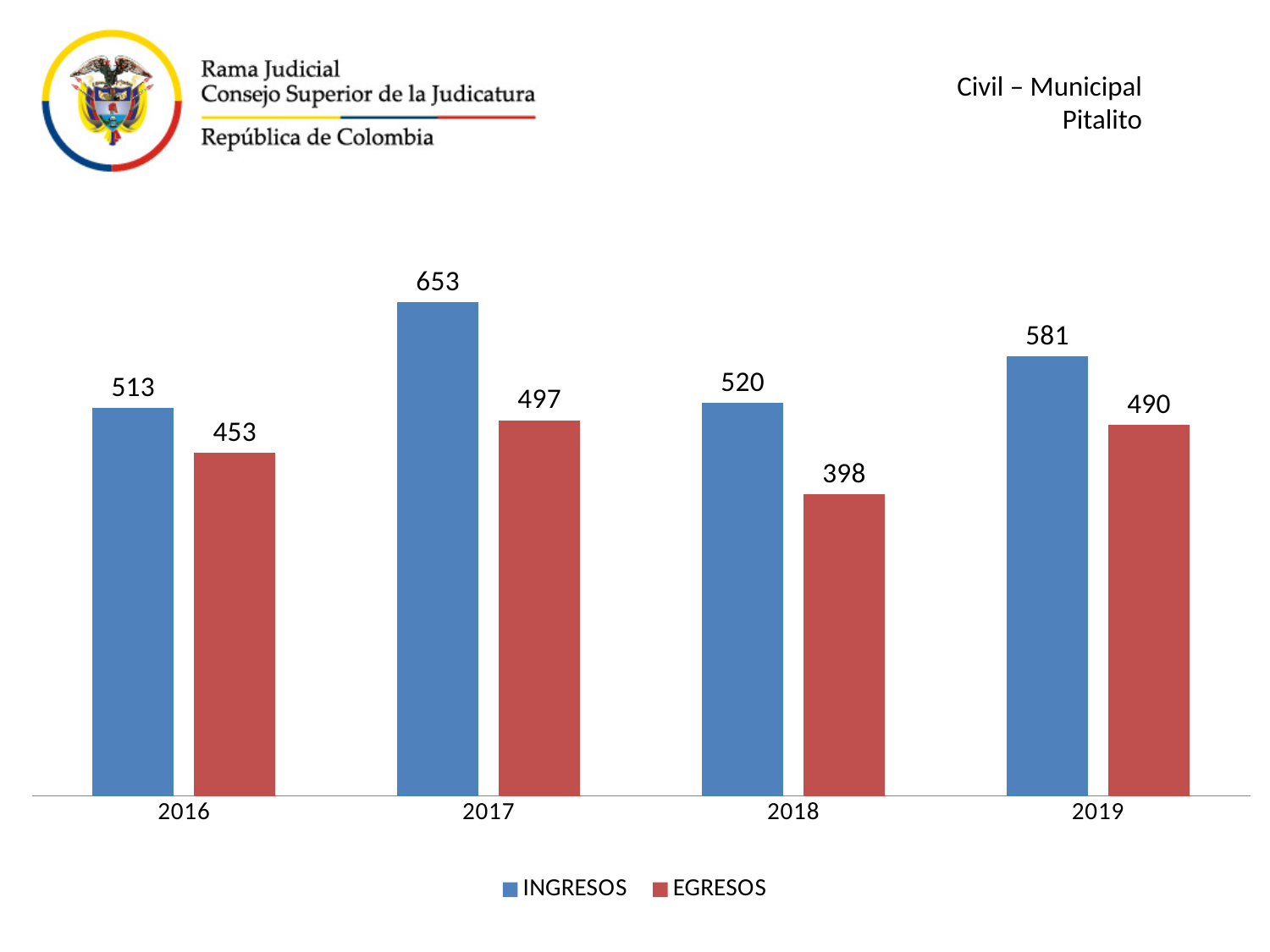
What is the difference between INGRESOS and EGRESOS in 2018? 122 Which colour represents the EGRESOS series? Red What kind of chart is shown on the slide? Bar chart Which year has the lowest EGRESOS value? 2018 What is the EGRESOS value for 2018? 398 What is the INGRESOS value for 2017? 653 Which year has the highest INGRESOS value? 2017 How many series does the legend list? 2 Which is larger, EGRESOS in 2017 or EGRESOS in 2019? EGRESOS in 2017 What is the difference between the INGRESOS values for 2017 and 2016? 140 What is the EGRESOS value for 2016? 453 How many years are shown on the x axis? 4